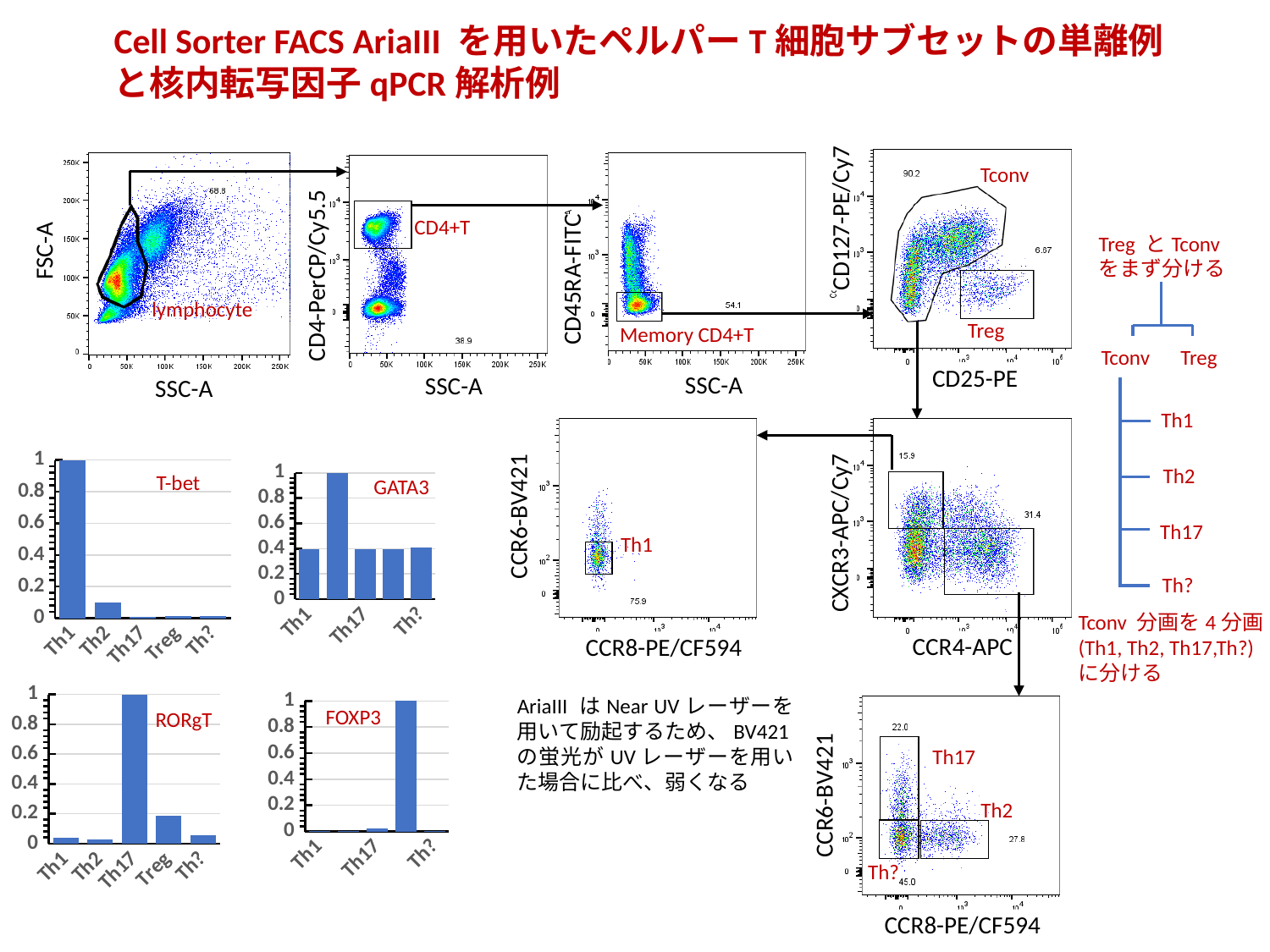
In the T-bet bar chart, what is the value for Th1? 1 What kind of chart is the FOXP3 chart? bar chart In the T-bet bar chart, is the value for Th2 greater or less than 0.2? less In the RORgT bar chart, which is larger, the value for Treg or the value for Th?? Treg In the T-bet bar chart, which is larger, the value for Th1 or the value for Th2? Th1 In the GATA3 bar chart, is the value for Th1 greater or less than 0.2? greater In the GATA3 bar chart, is the value for Th17 greater or less than 0.6? less In the FOXP3 bar chart, which category has the highest value? Treg In the T-bet bar chart, which category has the highest value? Th1 In the RORgT bar chart, what is the value for Th17? 1 In the RORgT bar chart, which category has the highest value? Th17 How many categories are shown in the T-bet bar chart? 5